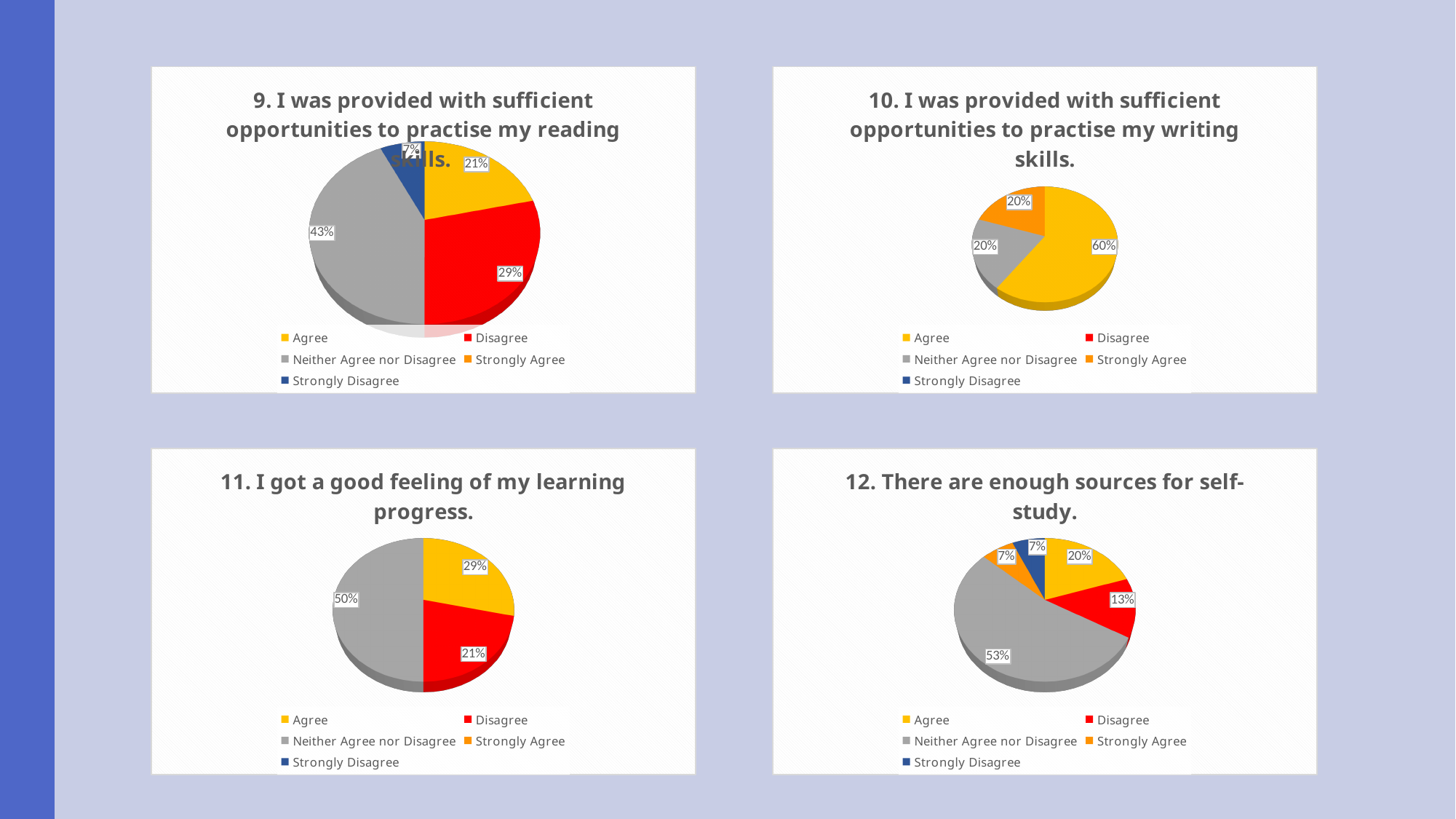
In the chart titled "9. I was provided with sufficient opportunities to practise my reading skills.", which response has the smallest slice? Strongly Disagree In the chart titled "10. I was provided with sufficient opportunities to practise my writing skills.", what percentage is shown for Strongly Agree? 20% In the chart titled "11. I got a good feeling of my learning progress.", what percentage is shown for Disagree? 21% In the chart titled "12. There are enough sources for self-study.", what percentage is shown for Disagree? 13% In the chart titled "12. There are enough sources for self-study.", what is the difference between the Neither Agree nor Disagree and Agree percentages? 33% In the chart titled "10. I was provided with sufficient opportunities to practise my writing skills.", what percentage is shown for Agree? 60% What type of chart is used in the chart titled "12. There are enough sources for self-study."? Pie chart In the chart titled "9. I was provided with sufficient opportunities to practise my reading skills.", what percentage is shown for Neither Agree nor Disagree? 43% In the chart titled "11. I got a good feeling of my learning progress.", which response has the largest slice? Neither Agree nor Disagree In the chart titled "10. I was provided with sufficient opportunities to practise my writing skills.", how many slices does the pie have? 3 In the chart titled "11. I got a good feeling of my learning progress.", which is larger, Agree or Disagree? Agree In the chart titled "9. I was provided with sufficient opportunities to practise my reading skills.", what is the difference between the Disagree and Agree percentages? 8%